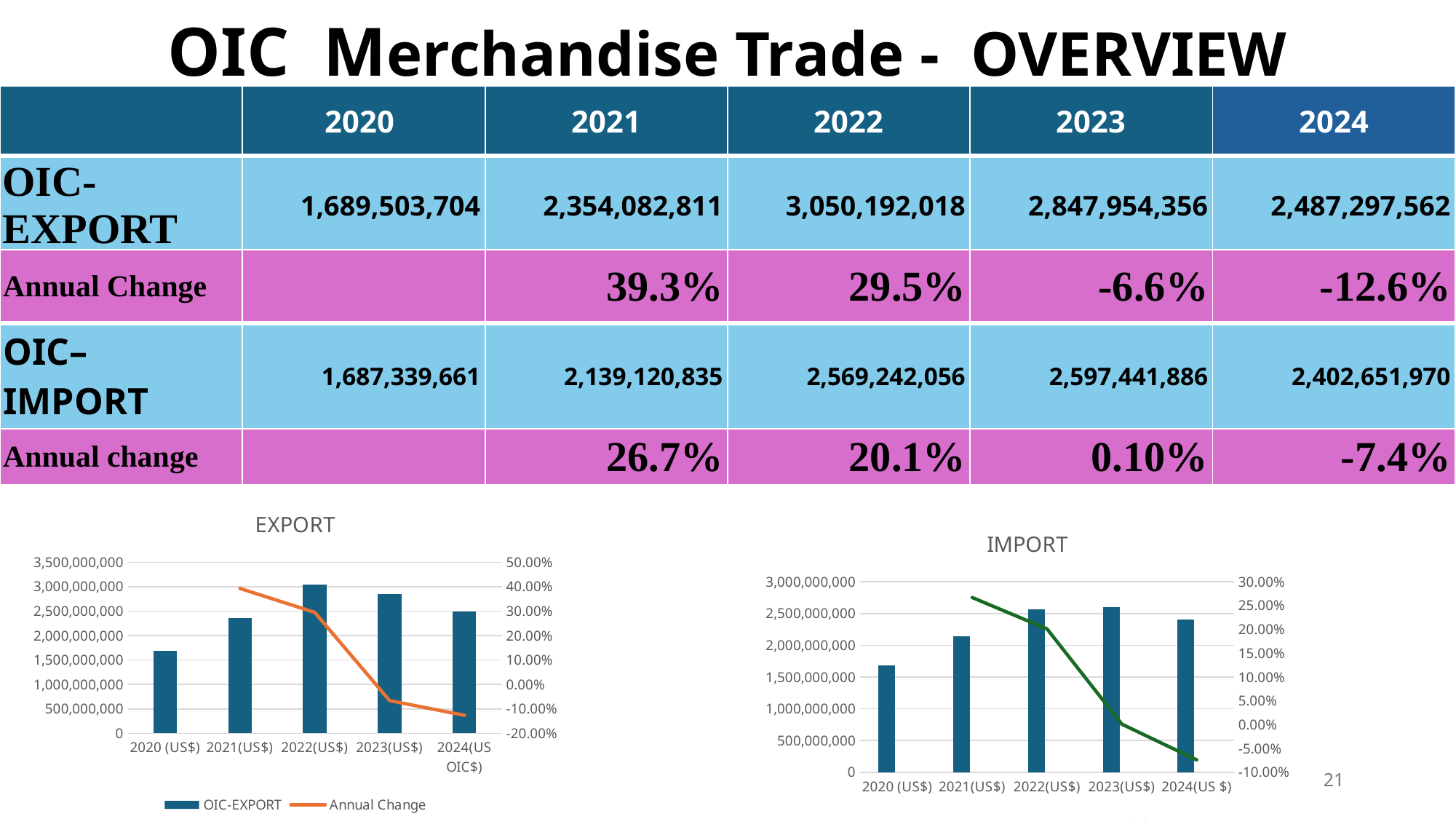
What colour is the Annual Change line in the EXPORT chart? orange In the EXPORT chart, is the Annual Change value for 2024 greater or less than 0.00%? less How many years are shown on the x axis of the IMPORT chart? 5 In the EXPORT chart, which year has the lowest OIC-EXPORT bar? 2020 (US$) What kind of chart is the EXPORT chart? combined bar and line chart In the IMPORT chart, which year has the highest import bar? 2023(US$) How many series does the legend of the EXPORT chart list? 2 In the EXPORT chart, is the OIC-EXPORT value for 2022 greater or less than 3,000,000,000? greater In the IMPORT chart, is the import value for 2020 greater or less than 2,000,000,000? less In the EXPORT chart, is the OIC-EXPORT bar for 2021 taller or shorter than the bar for 2023? shorter In the IMPORT chart, does the annual change line rise or fall from 2021 to 2024? fall In the EXPORT chart, which year has the highest OIC-EXPORT bar? 2022(US$)